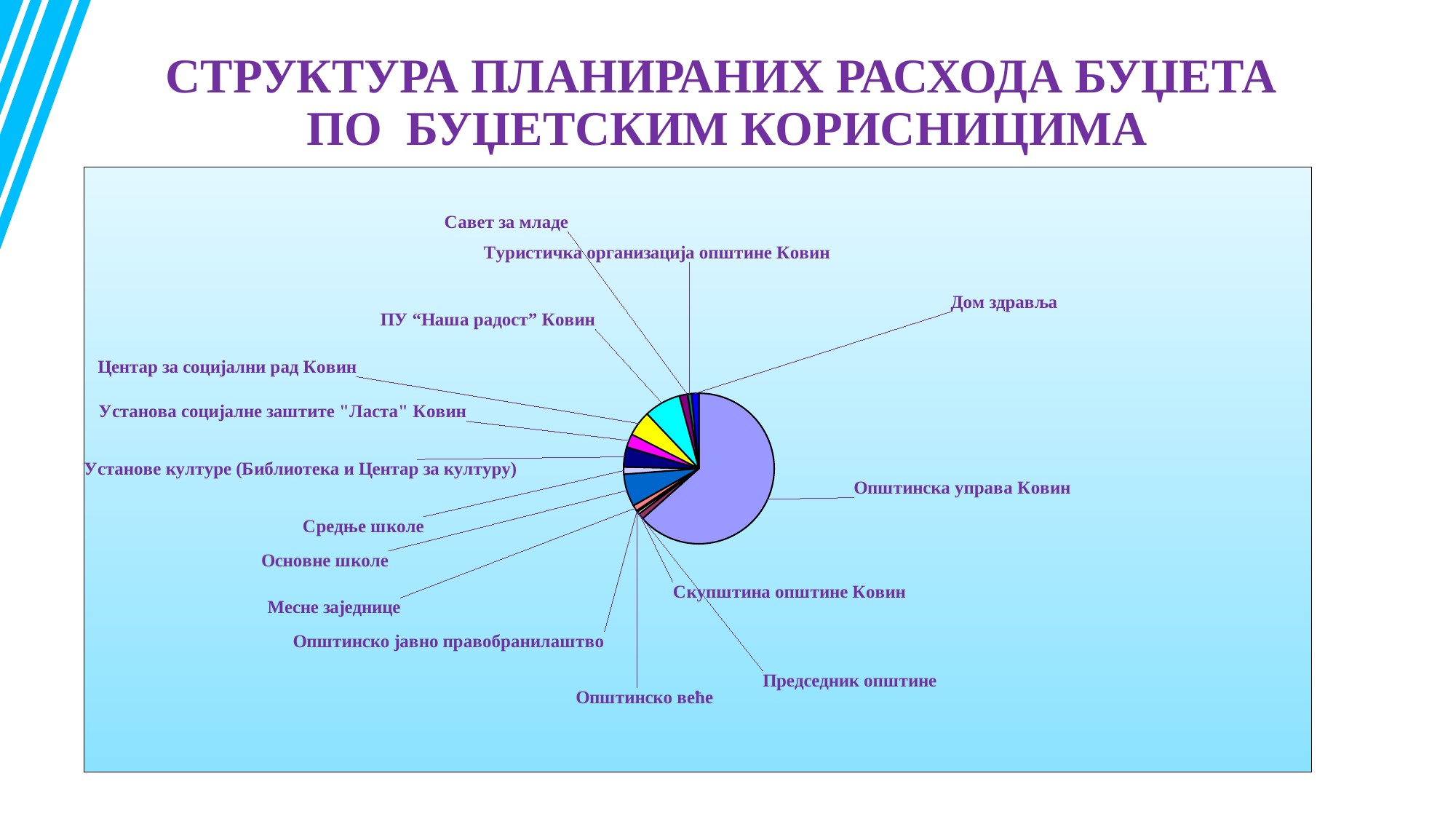
What colour is the slice for Општинска управа Ковин in the pie chart? light purple What kind of chart is shown on the slide? pie chart Which is larger in the pie chart: Општинска управа Ковин or Дом здравља? Општинска управа Ковин Which category has the largest slice in the pie chart? Општинска управа Ковин Which is larger in the pie chart: Општинска управа Ковин or Средње школе? Општинска управа Ковин What is the title of the slide containing the pie chart? СТРУКТУРА ПЛАНИРАНИХ РАСХОДА БУЏЕТА ПО БУЏЕТСКИМ КОРИСНИЦИМА